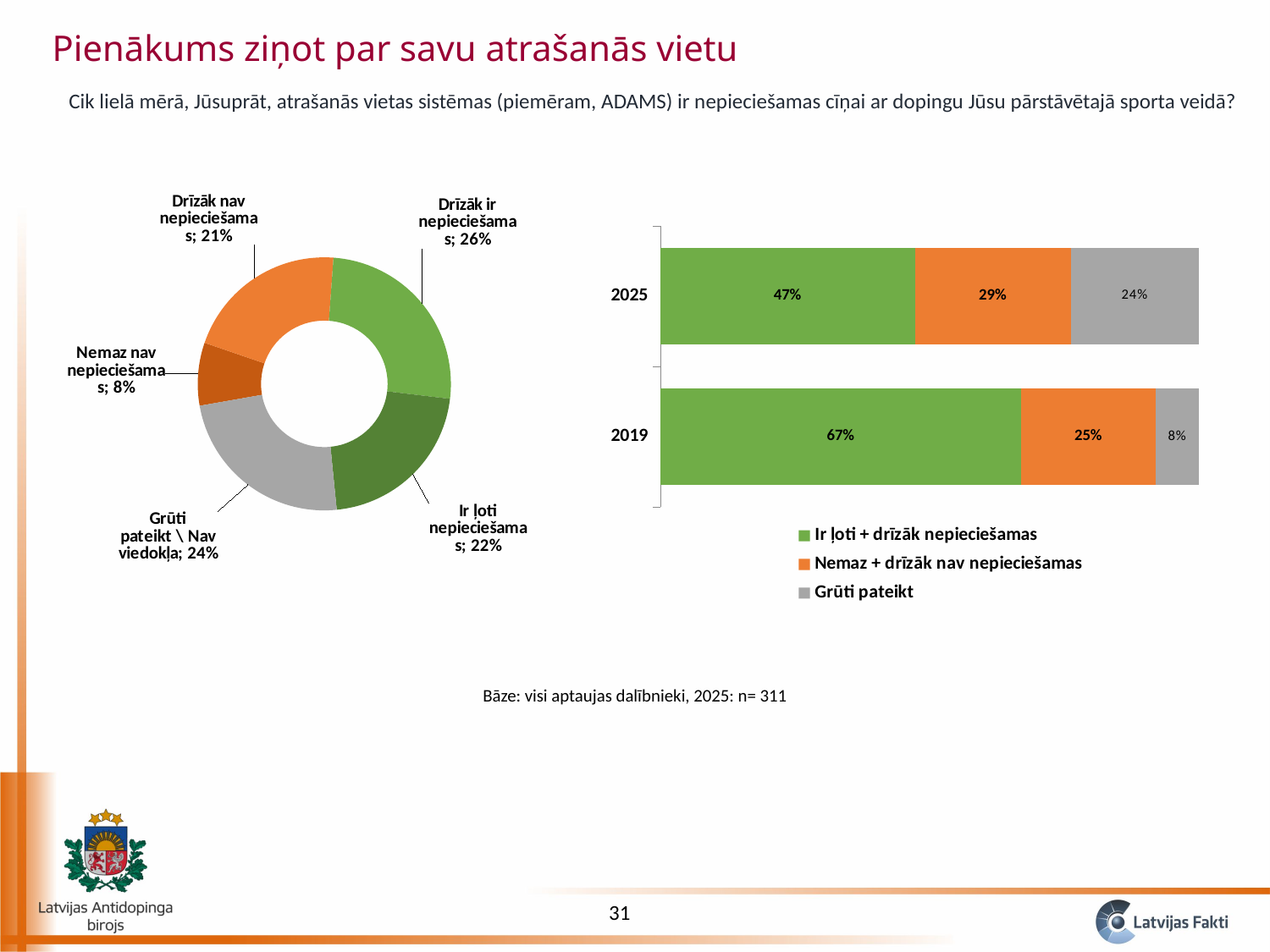
How many series does the legend of the stacked bar chart on the right list? 3 In the donut chart on the left, how many categories are shown? 5 In the donut chart on the left, what share is labelled "Nemaz nav nepieciešamas"? 8% What type of chart is shown on the right side of the slide? Stacked bar chart In the stacked bar chart on the right, which year has the larger value for "Ir ļoti + drīzāk nepieciešamas", 2019 or 2025? 2019 In the donut chart on the left, which category has the largest share? Drīzāk ir nepieciešamas In the stacked bar chart on the right, what is the value of "Ir ļoti + drīzāk nepieciešamas" for 2025? 47% In the stacked bar chart on the right, what is the value of "Grūti pateikt" for 2019? 8% In the donut chart on the left, what share is labelled "Drīzāk ir nepieciešamas"? 26% In the stacked bar chart on the right, what is the difference between the "Ir ļoti + drīzāk nepieciešamas" values for 2019 and 2025? 20 percentage points In the donut chart on the left, which category has the smallest share? Nemaz nav nepieciešamas In the donut chart on the left, what is the difference between the shares for "Grūti pateikt \ Nav viedokļa" and "Drīzāk nav nepieciešamas"? 3 percentage points